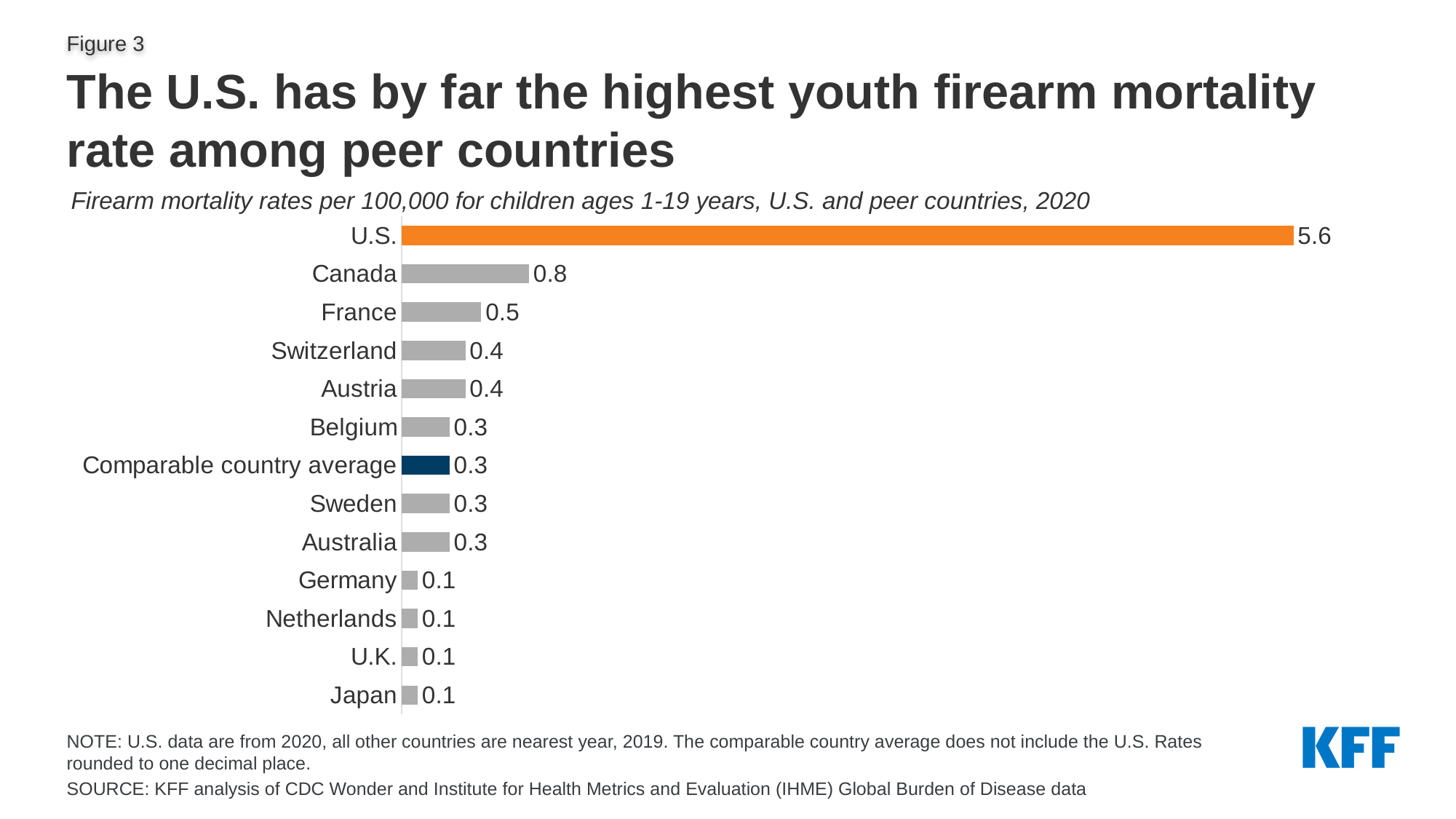
How many bars (categories) are shown on the chart? 13 Which bar is coloured orange on the chart? U.S. Which has a higher firearm mortality rate, Canada or France? Canada What is the firearm mortality rate per 100,000 for Canada? 0.8 What is the value shown for the Comparable country average? 0.3 What is the difference between the U.S. rate and the Comparable country average? 5.3 What is the firearm mortality rate per 100,000 for France? 0.5 What is the difference between the U.S. rate and the Canada rate? 4.8 Which country has the highest youth firearm mortality rate on the chart? U.S. What is the firearm mortality rate per 100,000 for the U.S.? 5.6 Which has a higher firearm mortality rate, Switzerland or Germany? Switzerland What type of chart is shown on the slide? Bar chart